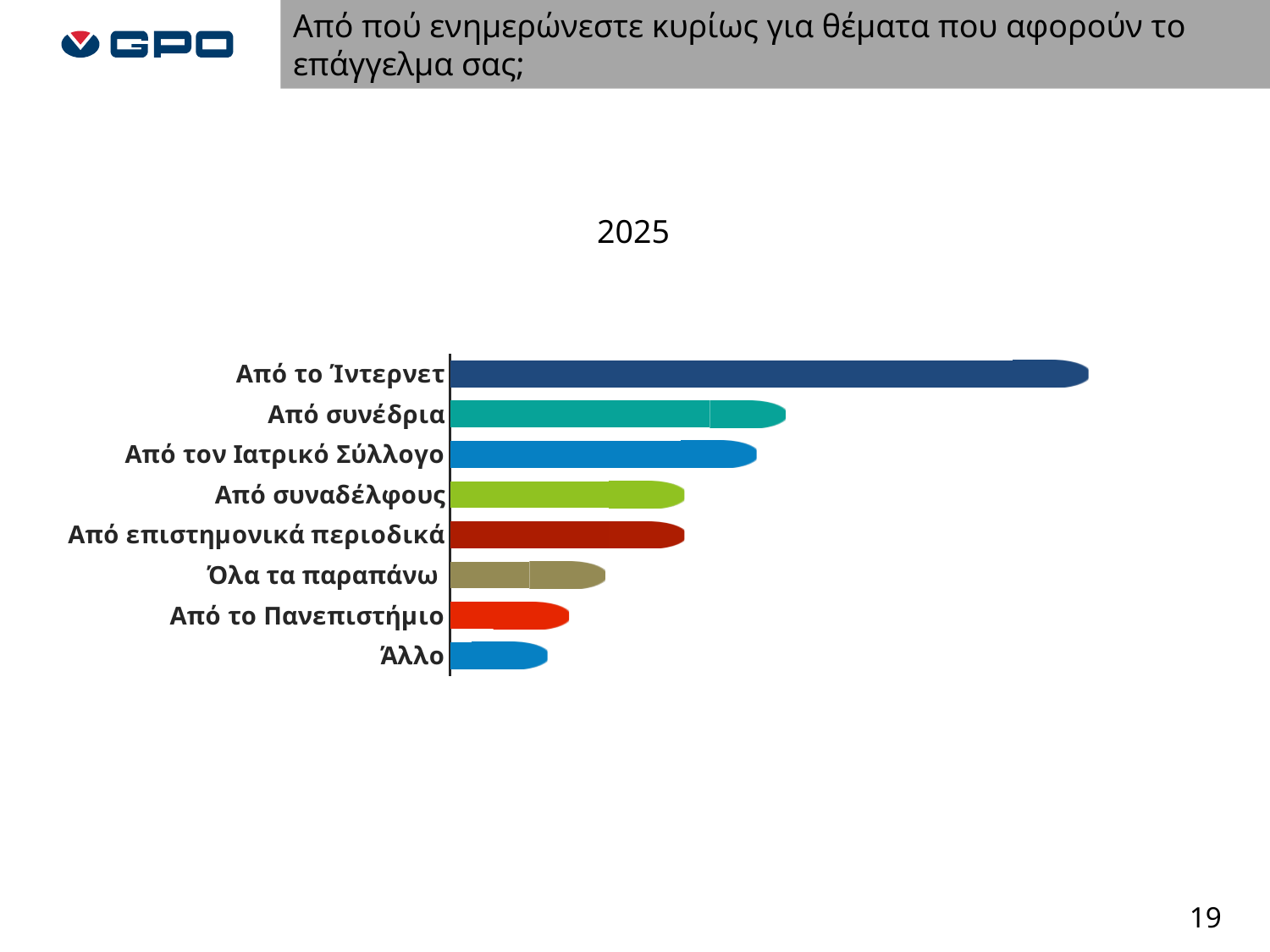
Which category is listed first (at the top) of the chart? Από το Ίντερνετ Which category has the highest value in the chart? Από το Ίντερνετ How many categories are shown in the chart? 8 Which is larger, the value for Όλα τα παραπάνω or the value for Από συναδέλφους? Από συναδέλφους Which is larger, the value for Από τον Ιατρικό Σύλλογο or the value for Όλα τα παραπάνω? Από τον Ιατρικό Σύλλογο Which is larger, the value for Από το Ίντερνετ or the value for Από συνέδρια? Από το Ίντερνετ Which category has the lowest value in the chart? Άλλο What is the title of the chart? 2025 What kind of chart is shown on the slide? bar chart